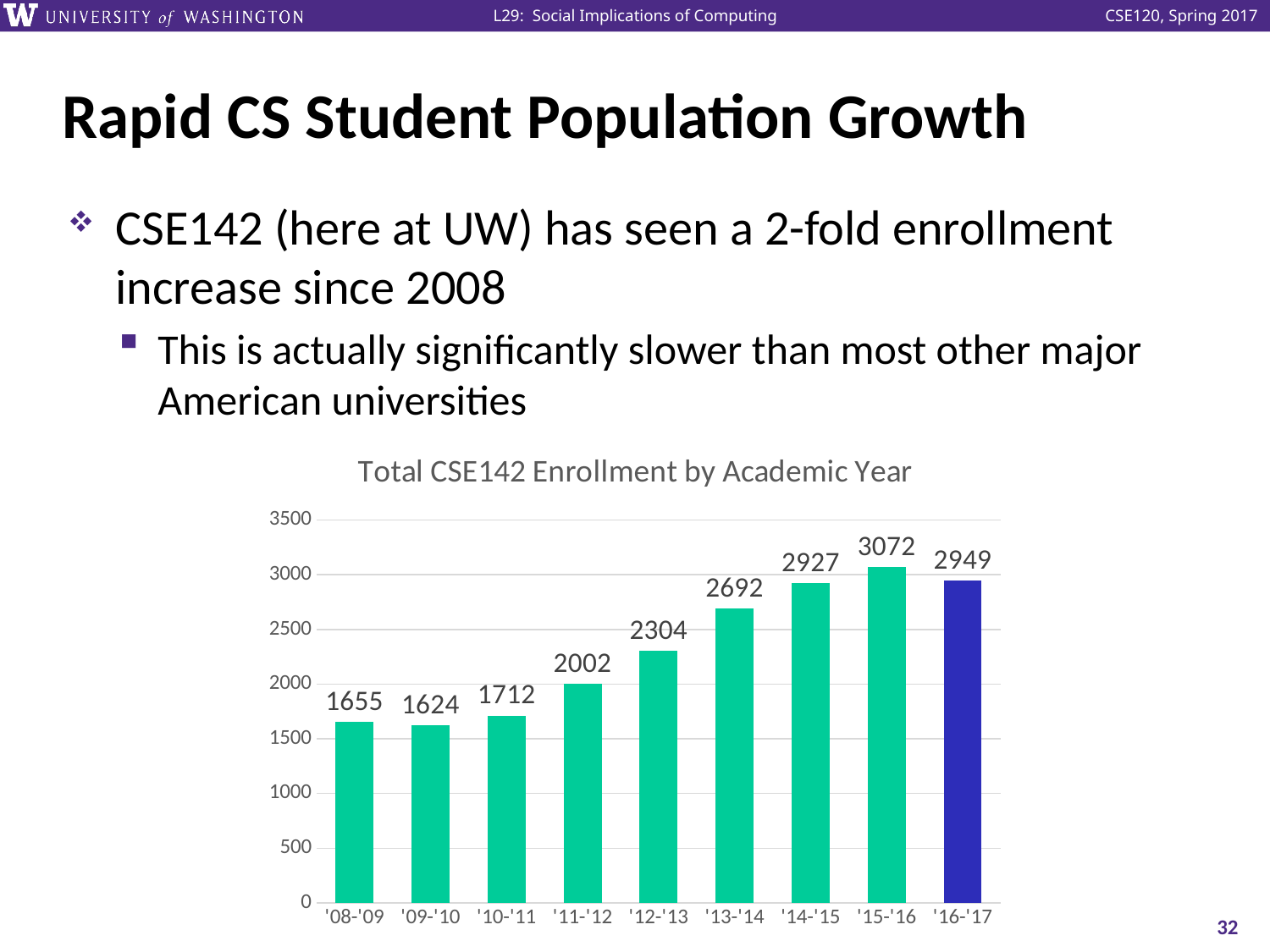
What is the total CSE142 enrollment for the '08-'09 academic year? 1655 Which academic year has higher enrollment, '14-'15 or '16-'17? '16-'17 Which academic year has the highest total CSE142 enrollment? '15-'16 Is the enrollment for '13-'14 greater or less than 2500? greater What is the difference in enrollment between '15-'16 and '08-'09? 1417 What is the difference in enrollment between '12-'13 and '11-'12? 302 Which academic year has the lowest total CSE142 enrollment? '09-'10 What is the title of the chart? Total CSE142 Enrollment by Academic Year What is the total CSE142 enrollment for the '13-'14 academic year? 2692 What is the total CSE142 enrollment for the '16-'17 academic year? 2949 What type of chart is used to show CSE142 enrollment by academic year? Bar chart How many academic years are shown in the chart? 9